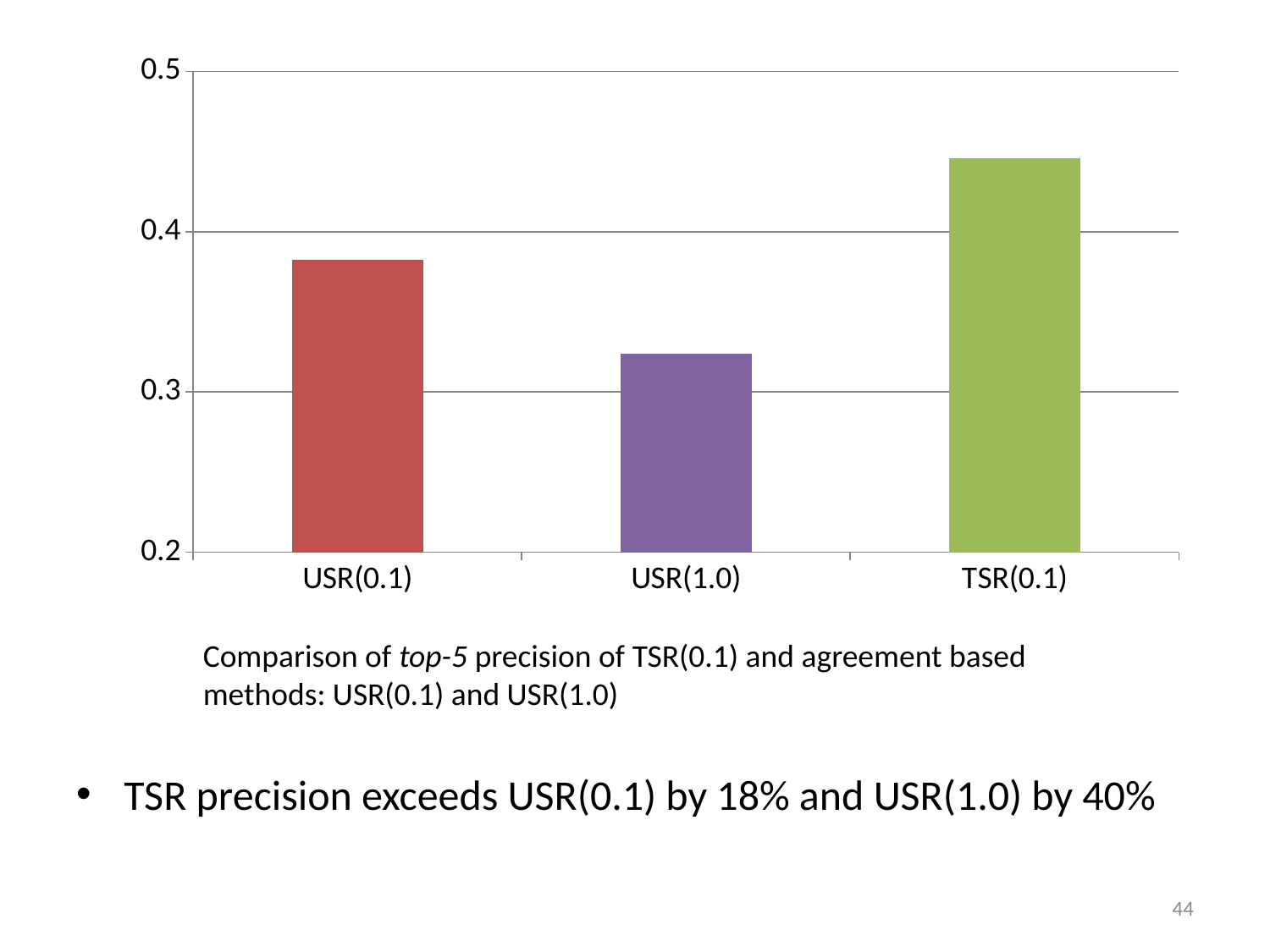
What is the lowest value shown on the vertical axis of the chart? 0.2 Which category has the lowest value in the chart? USR(1.0) What kind of chart is shown on the slide? bar chart Which is larger, the value for TSR(0.1) or the value for USR(0.1)? TSR(0.1) What colour is the bar for TSR(0.1)? green Is the value for USR(1.0) greater or less than 0.3? greater Which is larger, the value for USR(0.1) or the value for USR(1.0)? USR(0.1) How many bars (categories) are plotted in the chart? 3 Which category has the highest value in the chart? TSR(0.1) Is the value for TSR(0.1) greater or less than 0.4? greater Is the value for USR(0.1) greater or less than 0.4? less